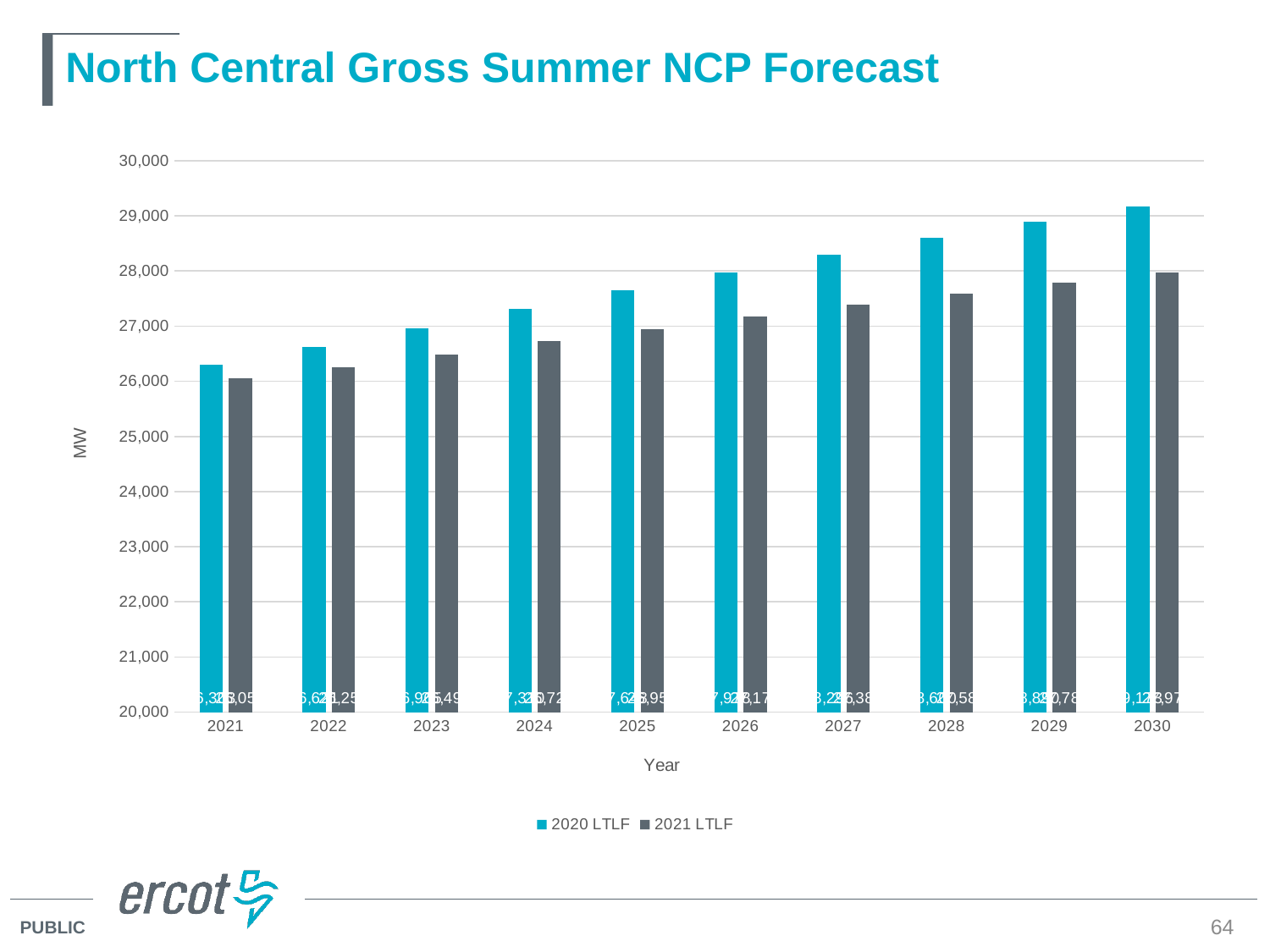
For 2030, which series has the larger value, 2020 LTLF or 2021 LTLF? 2020 LTLF Which year has the lowest 2021 LTLF value? 2021 What is the label on the y axis? MW What are the two legend entries? 2020 LTLF and 2021 LTLF Is the 2021 LTLF value for 2023 greater or less than 27,000? less How many series does the legend list? 2 How many years are shown on the x axis? 10 Do the 2021 LTLF values rise or fall from 2021 to 2030? rise Is the 2020 LTLF value for 2027 greater or less than 28,000? greater Which year has the highest 2020 LTLF value? 2030 Is the 2020 LTLF value for 2030 greater or less than 29,000? greater What kind of chart is shown on the slide? bar chart